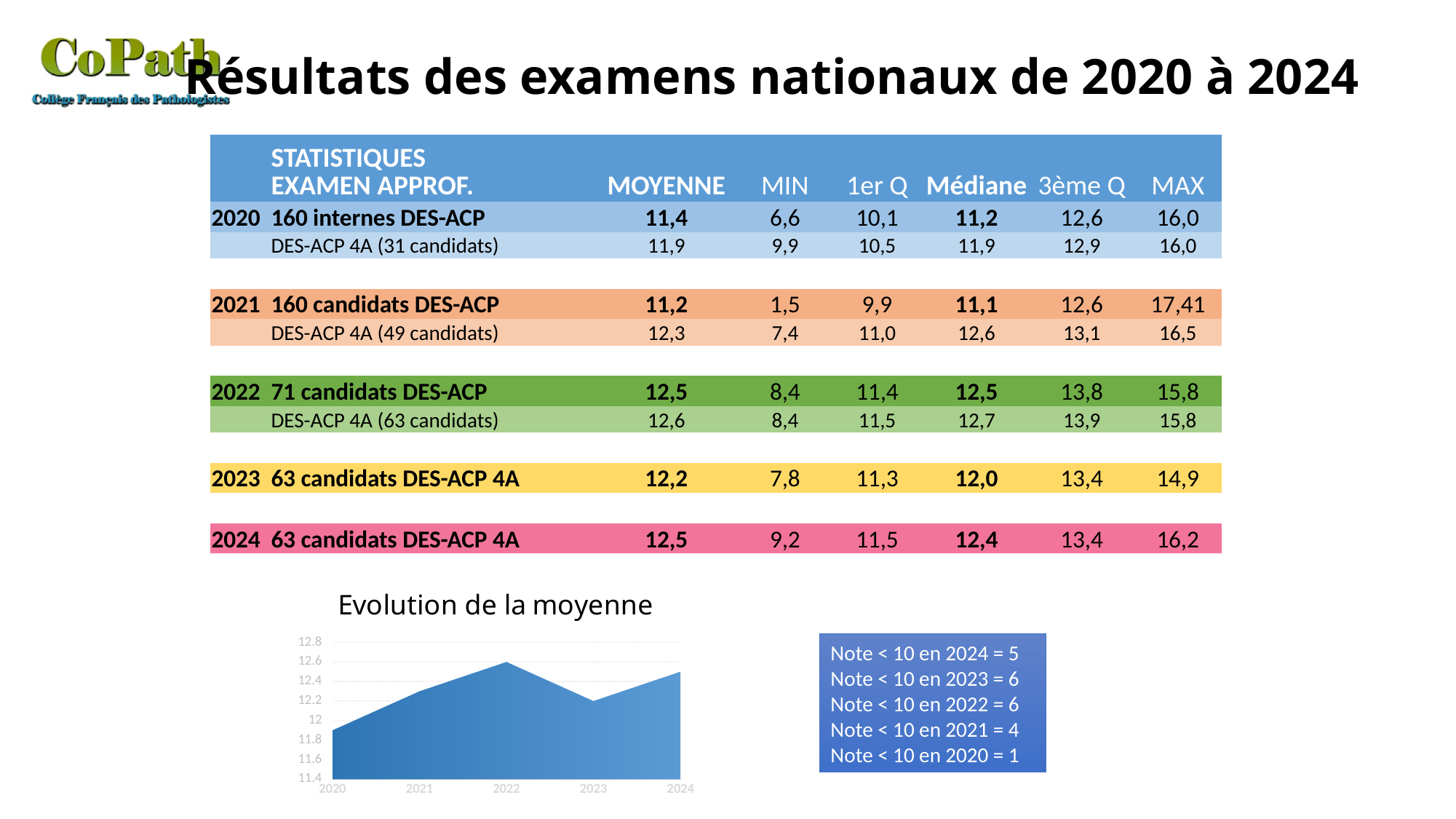
What is the highest value shown on the y axis of the "Evolution de la moyenne" chart? 12.8 In the "Evolution de la moyenne" chart, do the values rise or fall from 2020 to 2022? rise In the "Evolution de la moyenne" chart, which year has the highest value? 2022 What kind of chart is "Evolution de la moyenne"? area chart In the "Evolution de la moyenne" chart, is the value for 2020 greater or less than 12? less In the "Evolution de la moyenne" chart, is the value for 2024 greater or less than 12.2? greater In the "Evolution de la moyenne" chart, which year has the lowest value? 2020 How many years are plotted along the x axis of the "Evolution de la moyenne" chart? 5 In the "Evolution de la moyenne" chart, is the value for 2023 greater or less than 12? greater What is the title of the chart at the bottom of the slide? Evolution de la moyenne In the "Evolution de la moyenne" chart, which is larger, the value for 2022 or the value for 2023? 2022